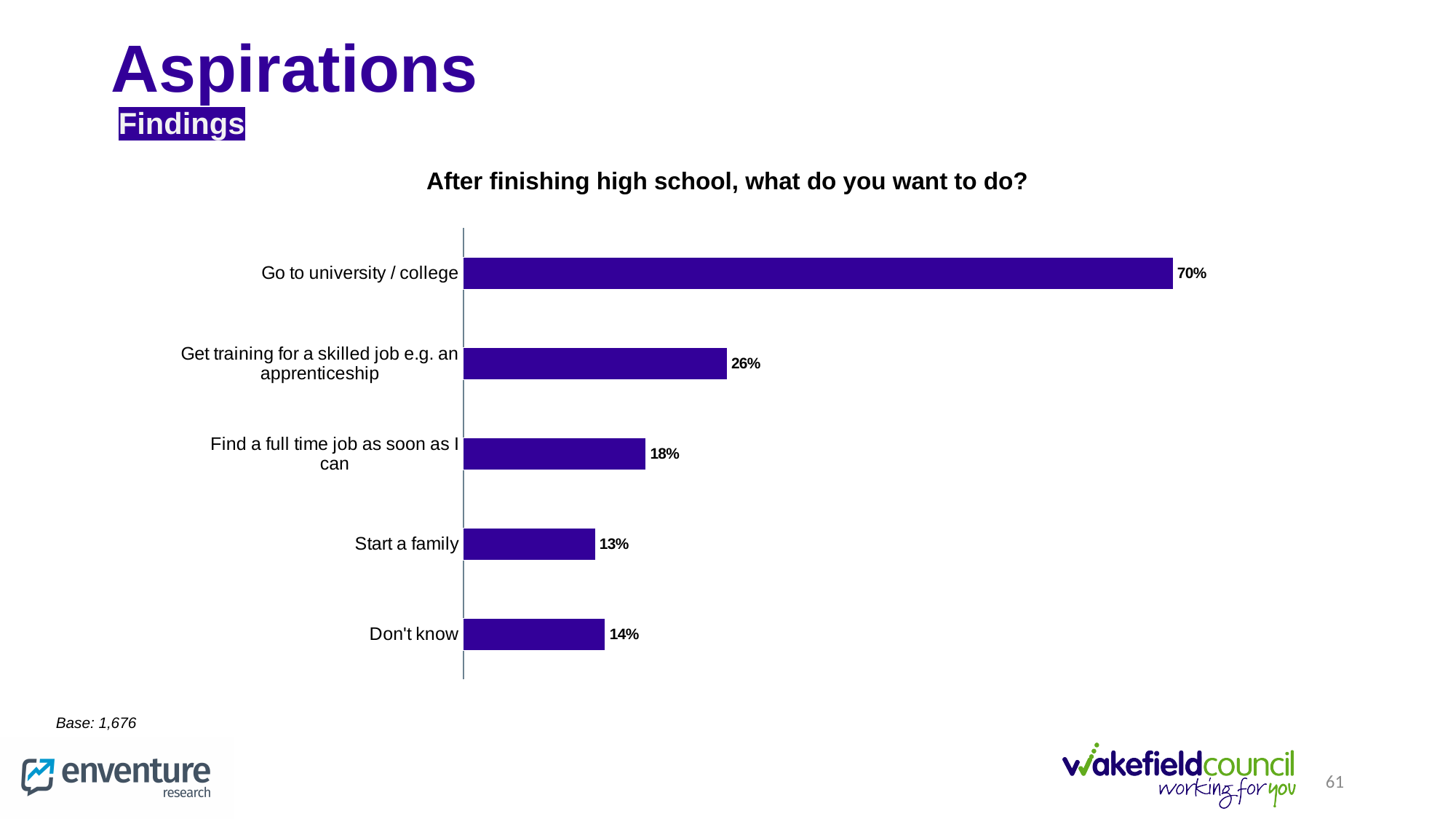
What is the title of the chart? After finishing high school, what do you want to do? What kind of chart is shown on the slide? Bar chart How many categories are shown in the chart? 5 What is the value for 'Start a family'? 13% What is the difference between the values for 'Go to university / college' and 'Get training for a skilled job e.g. an apprenticeship'? 44% What percentage of respondents want to go to university / college after finishing high school? 70% What percentage of respondents want to find a full time job as soon as they can? 18% Which category has the lowest value? Start a family What percentage of respondents answered 'Don't know'? 14% What is the value for 'Get training for a skilled job e.g. an apprenticeship'? 26% Which is larger: the value for 'Find a full time job as soon as I can' or the value for 'Don't know'? Find a full time job as soon as I can Which category has the highest value? Go to university / college